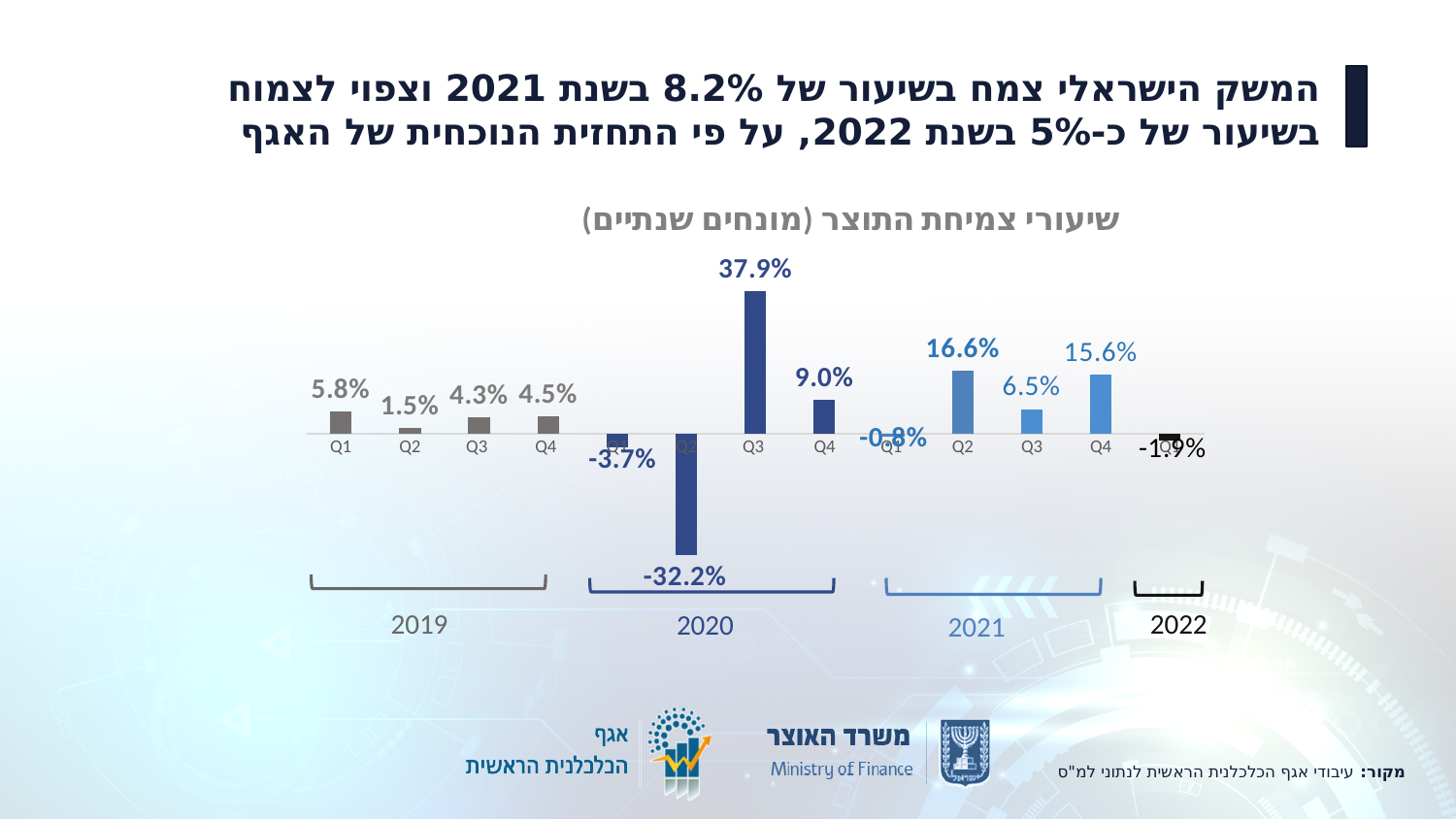
What is the value shown for Q2 of 2021? 16.6% What is the title of the chart? שיעורי צמיחת התוצר (מונחים שנתיים) Which quarter has the lowest growth rate in the chart? Q2 2020 Which quarter has the highest growth rate in the chart? Q3 2020 Which is larger, the value for Q4 2019 or the value for Q3 2019? Q4 2019 How many quarters are plotted for the year 2019? 4 Do the values rise or fall from Q1 2020 to Q2 2020? fall What is the difference between the values for Q4 2021 and Q3 2021? 9.1% What is the GDP growth rate shown for Q3 of 2020? 37.9% What kind of chart is shown on the slide? bar chart What is the value shown for Q1 of 2019? 5.8% What is the value shown for Q2 of 2020? -32.2%